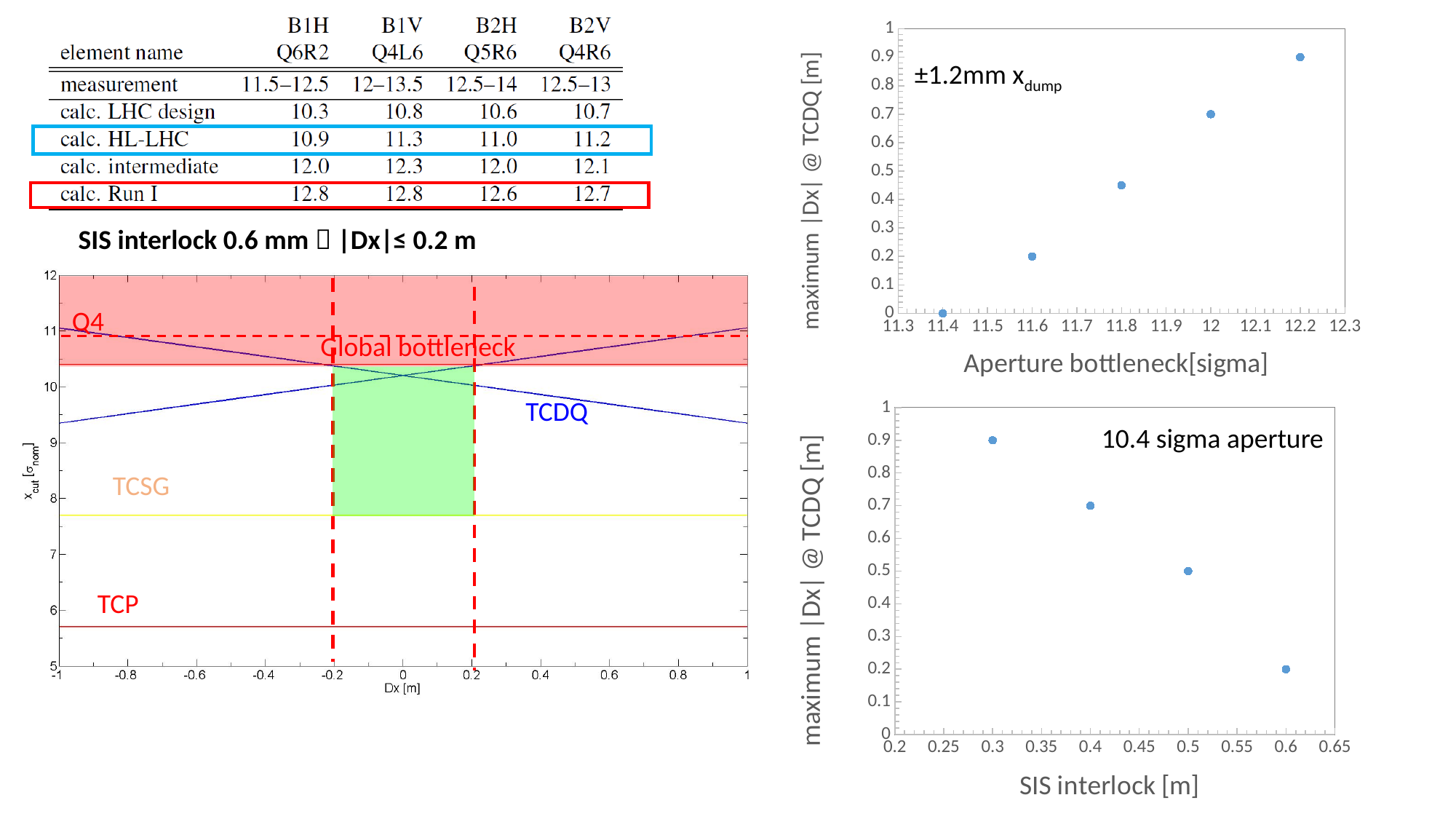
In the top-right chart (maximum |Dx| @ TCDQ vs Aperture bottleneck), how many data points are plotted? 5 In the top-right chart (maximum |Dx| @ TCDQ vs Aperture bottleneck), do the values rise or fall as the aperture bottleneck increases? rise In the bottom-right chart (maximum |Dx| @ TCDQ vs SIS interlock), how many data points are plotted? 4 In the bottom-right chart (maximum |Dx| @ TCDQ vs SIS interlock), what is the difference between the values at 0.3 m and 0.6 m? 0.7 In the top-right chart (maximum |Dx| @ TCDQ vs Aperture bottleneck), what is the value at an aperture bottleneck of 11.6 sigma? 0.2 In the top-right chart (maximum |Dx| @ TCDQ vs Aperture bottleneck), what is the value at an aperture bottleneck of 12.2 sigma? 0.9 In the bottom-right chart (maximum |Dx| @ TCDQ vs SIS interlock), do the values rise or fall as the SIS interlock increases? fall In the top-right chart (maximum |Dx| @ TCDQ vs Aperture bottleneck), is the value at 11.8 sigma greater or less than 0.4? greater In the left chart (x_cut vs Dx), is the TCP line greater or less than 6? less What kind of chart is the bottom-right chart (maximum |Dx| @ TCDQ vs SIS interlock)? scatter chart In the top-right chart (maximum |Dx| @ TCDQ vs Aperture bottleneck), at which aperture bottleneck value is maximum |Dx| lowest? 11.4 In the bottom-right chart (maximum |Dx| @ TCDQ vs SIS interlock), what is the value at an SIS interlock of 0.5 m? 0.5